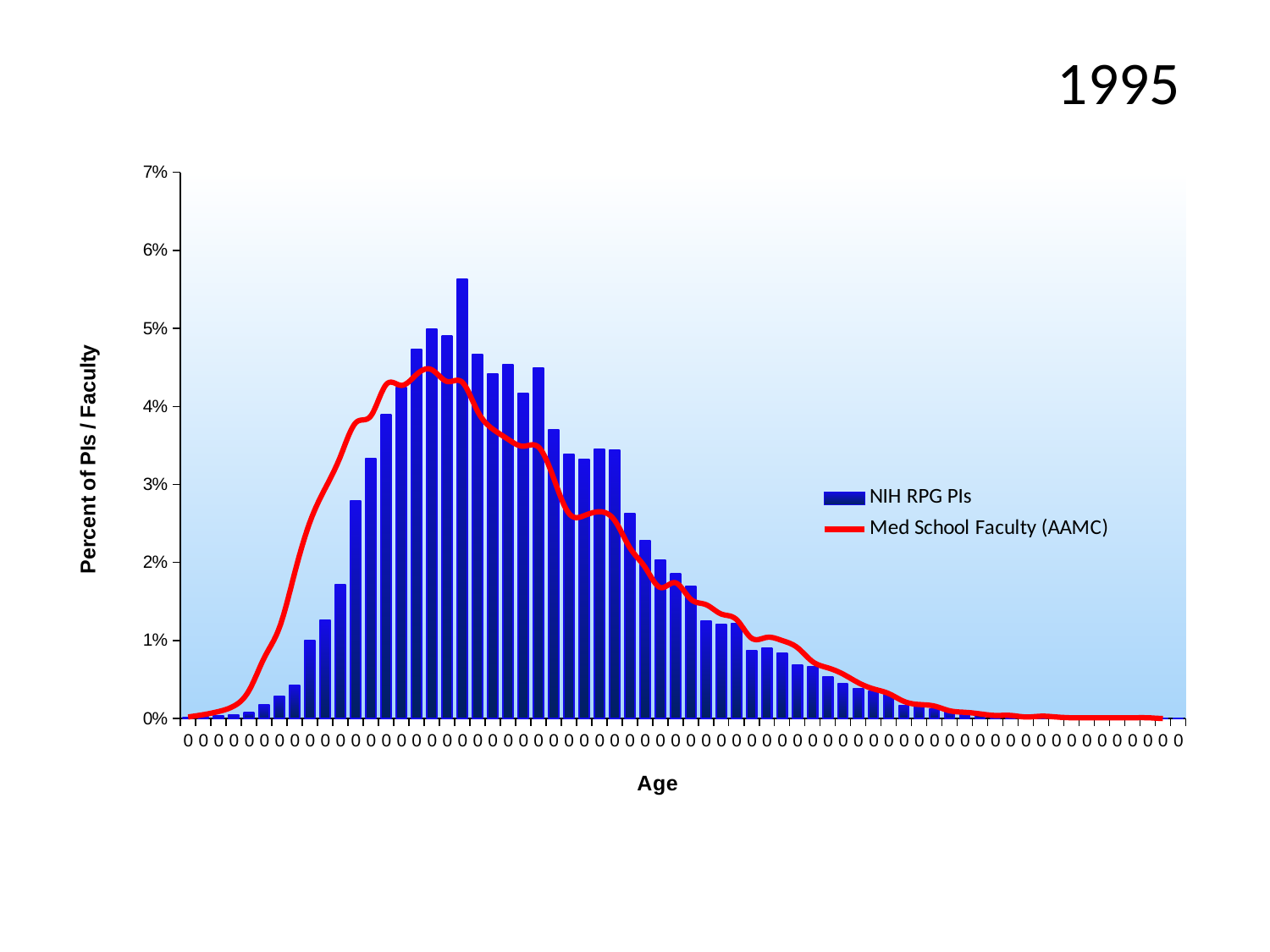
Which series reaches a higher peak value, NIH RPG PIs or Med School Faculty (AAMC)? NIH RPG PIs What is the title of the y axis? Percent of PIs / Faculty Is the highest point of the Med School Faculty (AAMC) line greater or less than 4%? greater What is the maximum value shown on the y axis? 7% Is the tallest NIH RPG PIs bar greater or less than 5%? greater Which series is drawn as bars? NIH RPG PIs Toward the right end of the x axis, do the NIH RPG PIs bars rise or fall? fall How many series does the legend list? 2 Is the highest point of the Med School Faculty (AAMC) line greater or less than 5%? less